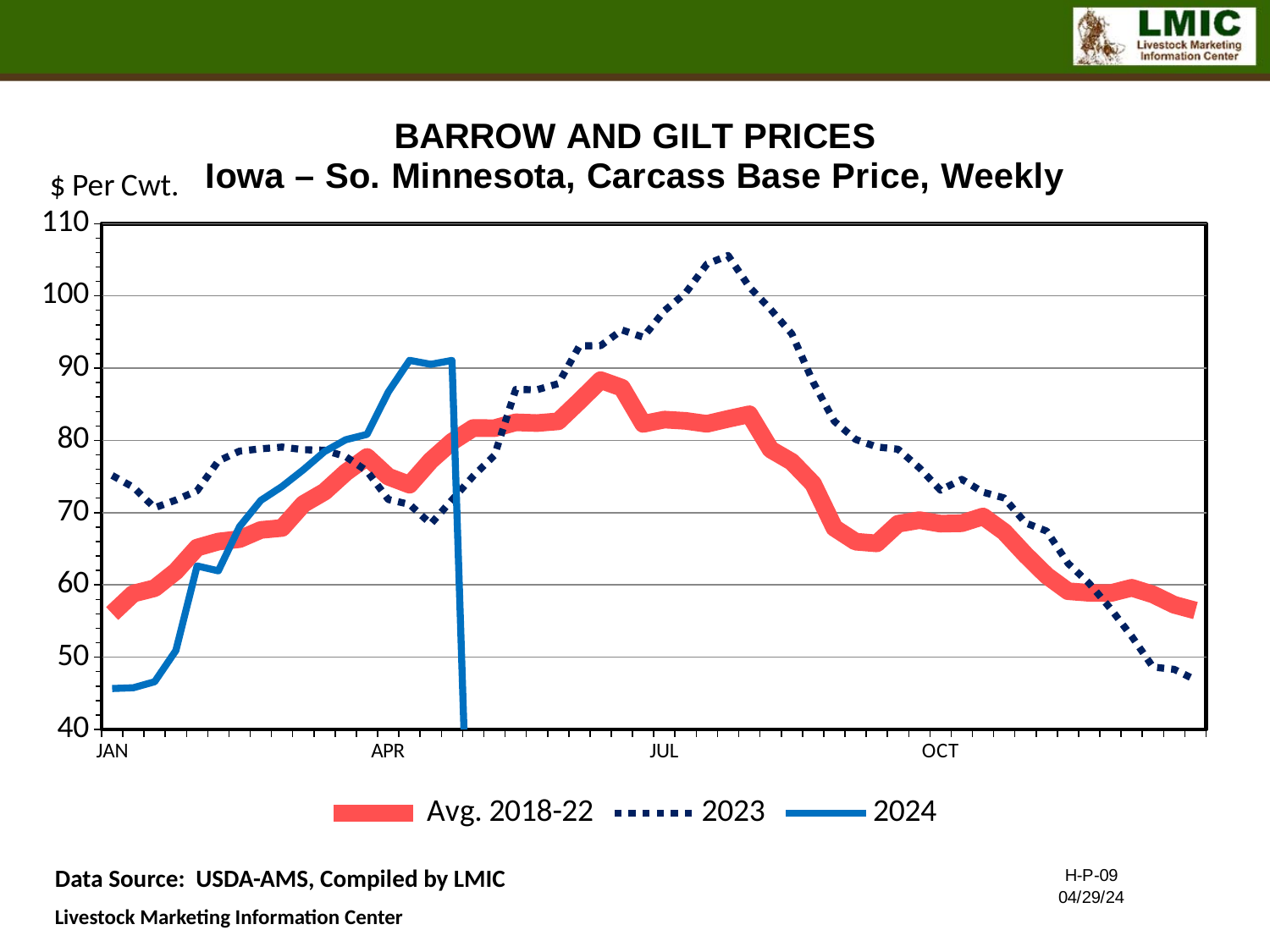
Does the 2023 series rise or fall from August to December? fall What is the title of the chart? BARROW AND GILT PRICES What unit is shown on the vertical axis label? $ Per Cwt. Is the value of the 2024 series at the start of January greater or less than 50? less Is the value of the Avg. 2018-22 series at the end of December greater or less than 60? less Does the 2024 series rise or fall from January to April? rise Is the peak value of the 2024 series in April greater or less than 80? greater In January, which series is higher, 2023 or 2024? 2023 What kind of chart is shown on the slide? line chart How many series does the legend list? 3 Which series reaches the highest value on the chart? 2023